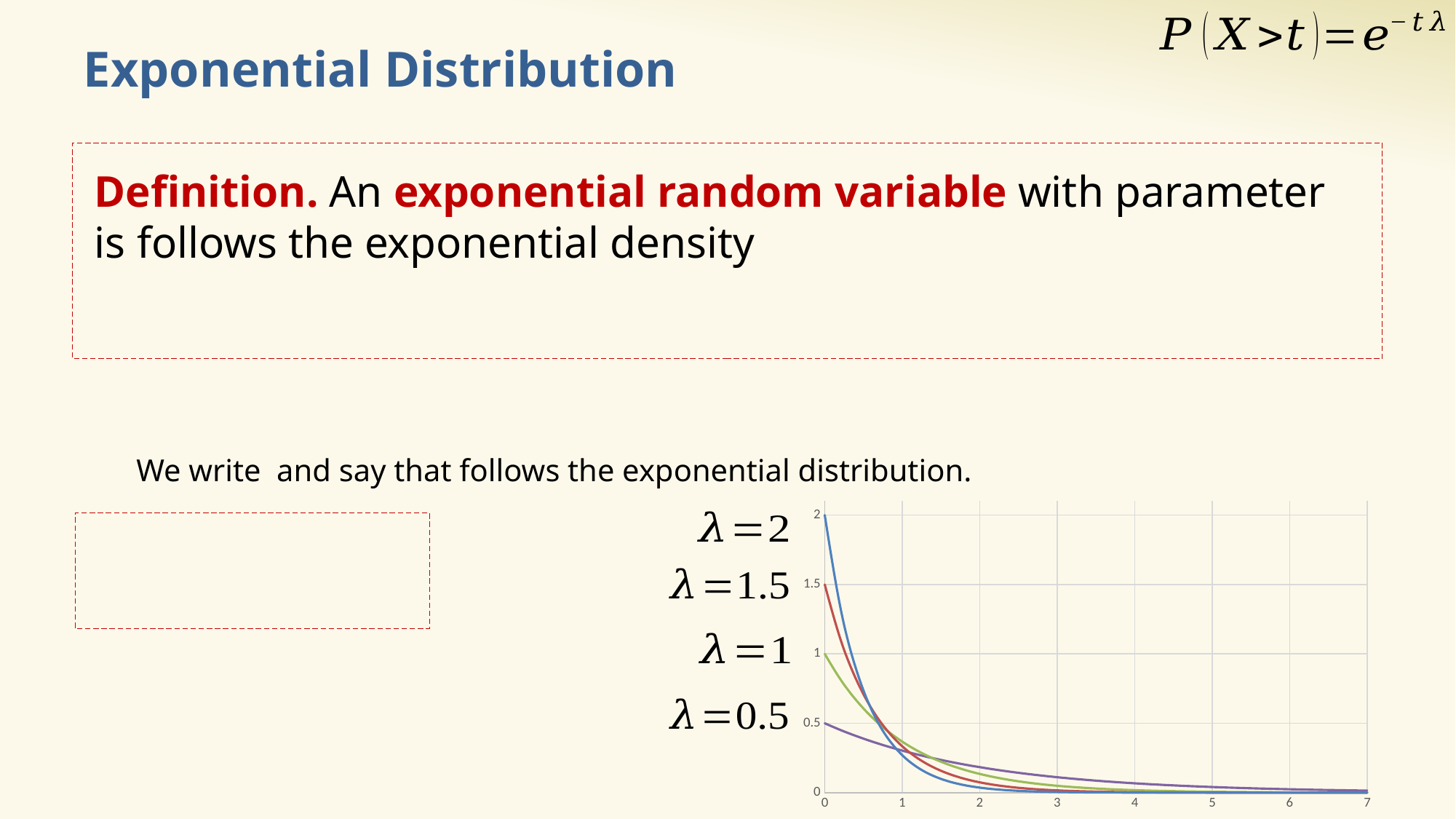
What is the value of the λ = 0.5 curve at x = 0? 0.5 What colour is the curve for λ = 2? blue Do the curves rise or fall as x increases along the x axis? fall At x = 0, which is larger: the λ = 1 curve or the λ = 0.5 curve? λ = 1 What kind of chart is shown on the slide? line chart What is the value of the λ = 1.5 curve at x = 0? 1.5 Which curve has the highest value at x = 0? λ = 2 What is the value of the λ = 2 curve at x = 0? 2 How many curves are plotted on the chart? 4 Which curve has the lowest value at x = 0? λ = 0.5 What is the largest value shown on the x axis? 7 Is the value of the λ = 2 curve at x = 2 greater or less than 0.5? less